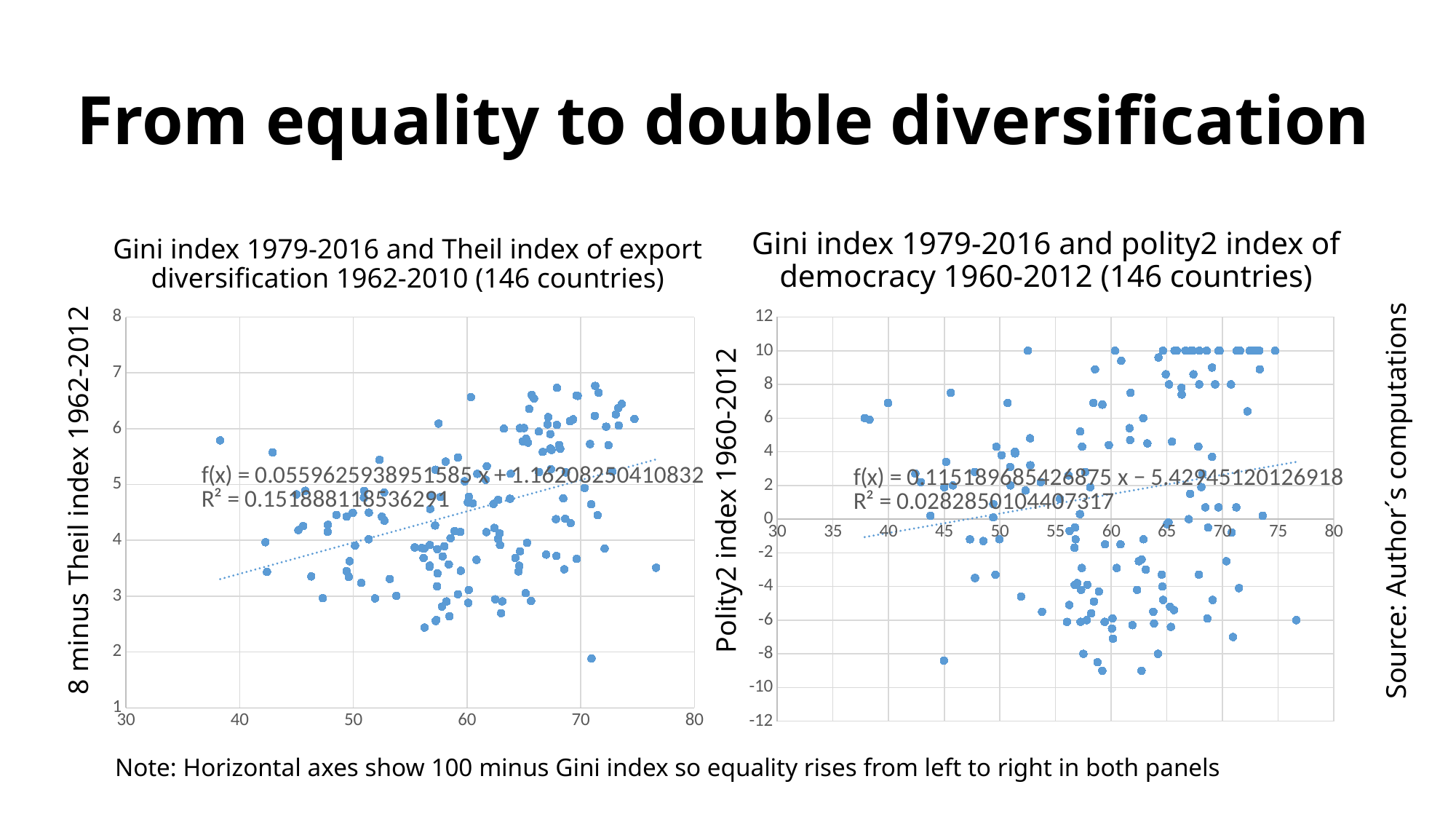
What is the slope coefficient in the trendline equation printed on the left chart (Theil index of export diversification)? 0.0559625938951585 How many countries does the title of each chart say are included? 146 In the right chart (polity2 index of democracy), does the fitted trendline rise or fall from left to right? Rises Which chart has the higher printed R² value, the left chart (Theil index) or the right chart (polity2 index)? The left chart (Theil index) What kind of chart is the left chart, titled 'Gini index 1979-2016 and Theil index of export diversification 1962-2010 (146 countries)'? Scatter chart What R² value is printed on the left chart (Theil index of export diversification)? 0.151888118536291 What is the vertical axis label of the left chart? 8 minus Theil index 1962-2012 What is the intercept in the trendline equation printed on the right chart (polity2 index of democracy)? -5.42945120126918 What is the maximum value shown on the vertical axis of the right chart (polity2 index of democracy)? 12 In the left chart (Theil index of export diversification), does the fitted trendline rise or fall as the horizontal axis value increases? Rises What R² value is printed on the right chart (polity2 index of democracy)? 0.0282850104407317 What kind of chart is the right chart, titled 'Gini index 1979-2016 and polity2 index of democracy 1960-2012 (146 countries)'? Scatter chart